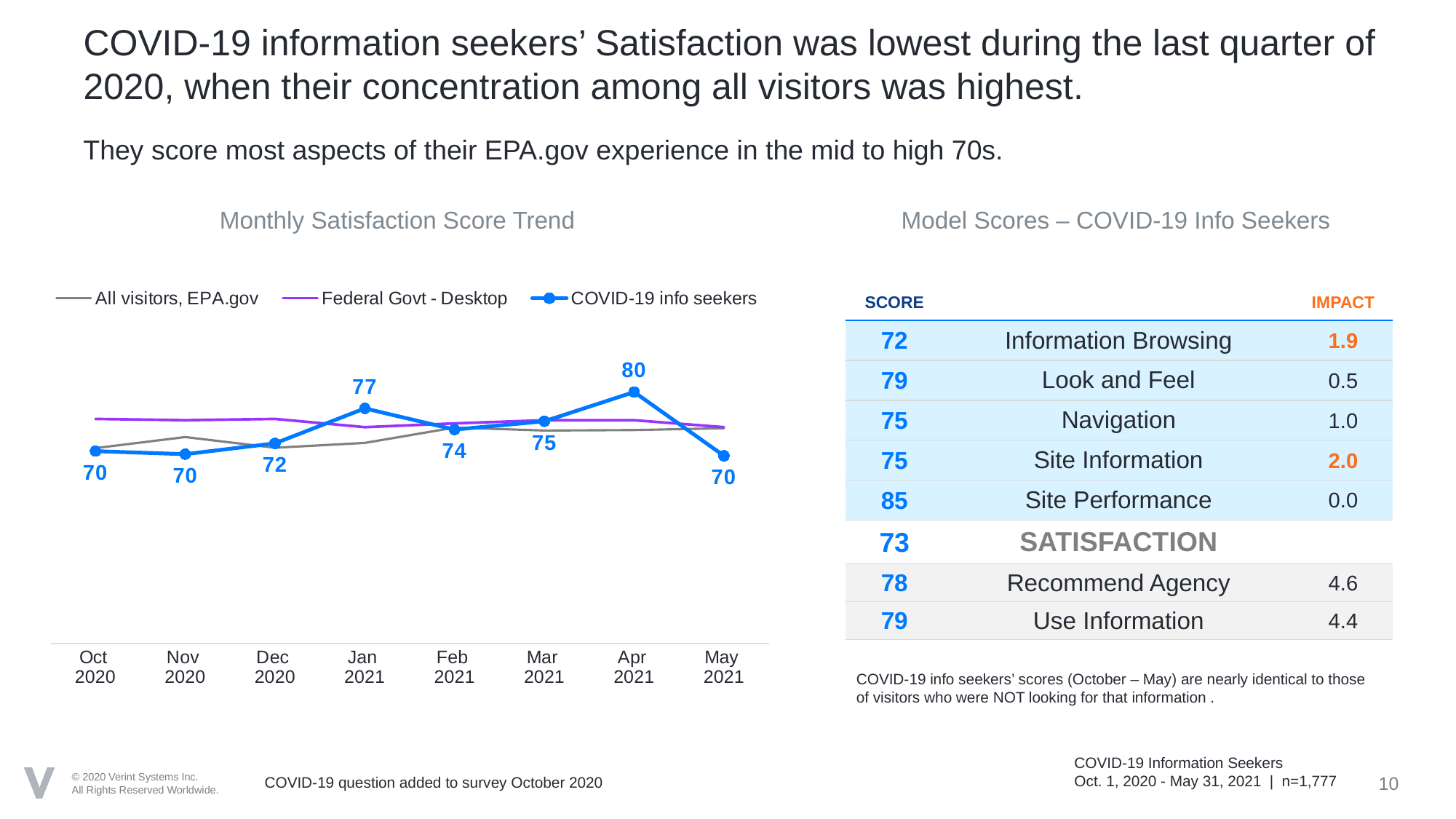
Which is larger for COVID-19 info seekers: the score for Feb 2021 or the score for Mar 2021? Mar 2021 What is the COVID-19 info seekers satisfaction score for Dec 2020? 72 What is the difference between the COVID-19 info seekers scores for Apr 2021 and May 2021? 10 What is the lowest COVID-19 info seekers satisfaction score shown on the chart? 70 Which series in the Monthly Satisfaction Score Trend chart is drawn in purple? Federal Govt - Desktop What type of chart is the Monthly Satisfaction Score Trend? Line chart How many months are plotted on the x axis of the Monthly Satisfaction Score Trend chart? 8 What is the COVID-19 info seekers satisfaction score for Apr 2021? 80 What is the COVID-19 info seekers satisfaction score for Jan 2021? 77 In which month is the COVID-19 info seekers satisfaction score highest? Apr 2021 Does the COVID-19 info seekers score rise or fall from Apr 2021 to May 2021? Fall How many series does the legend of the Monthly Satisfaction Score Trend chart list? 3